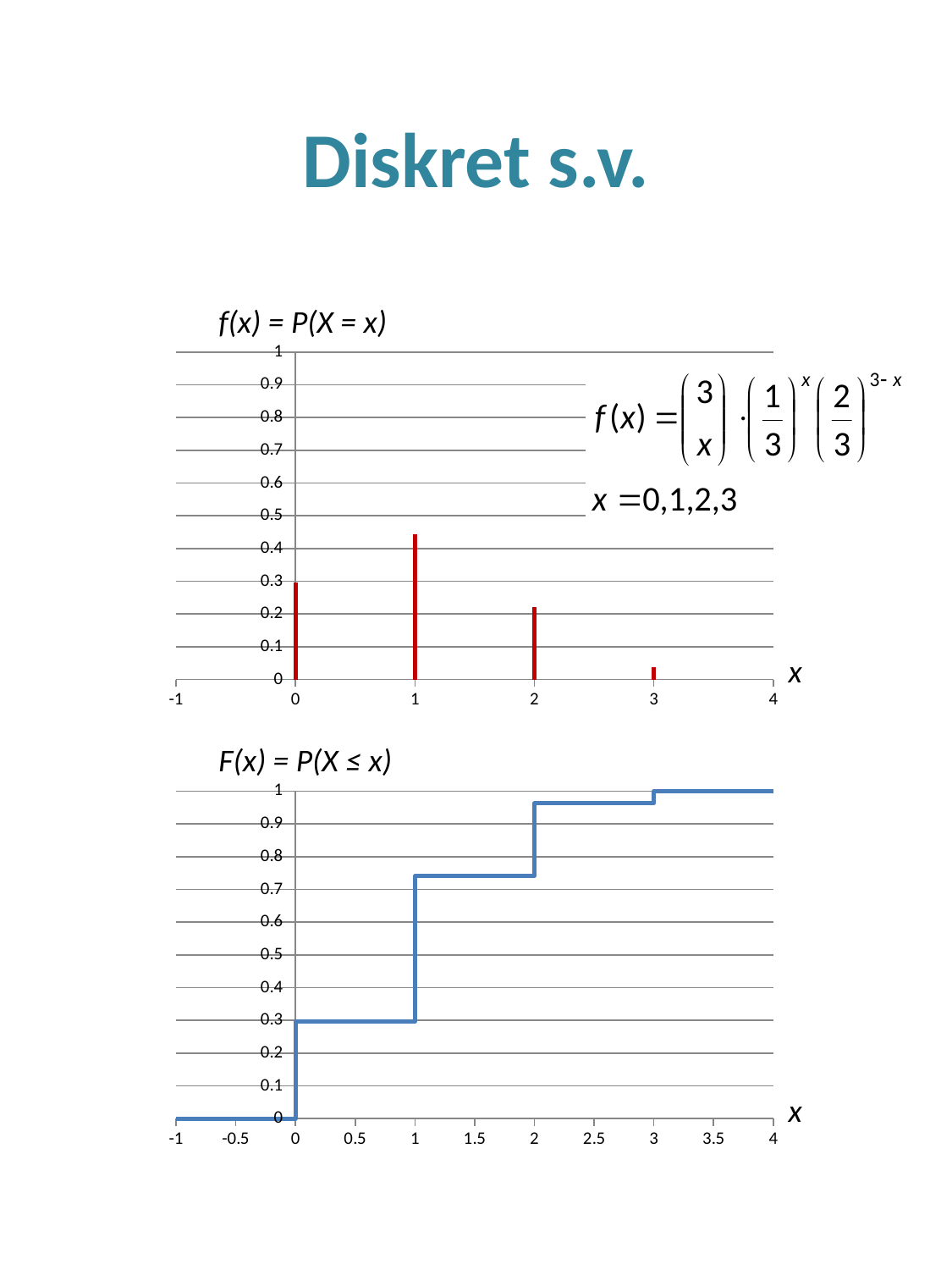
In the top chart f(x) = P(X = x), is the value at x = 1 greater or less than 0.4? greater In the bottom chart F(x) = P(X ≤ x), is the value at x = 0.5 greater or less than 0.4? less In the top chart f(x) = P(X = x), is the value at x = 3 greater or less than 0.1? less What colour is the line in the bottom chart F(x) = P(X ≤ x)? blue In the top chart f(x) = P(X = x), how many bars are plotted? 4 What kind of chart is the top chart titled f(x) = P(X = x)? bar chart In the top chart f(x) = P(X = x), which bar is taller, the one at x = 0 or the one at x = 2? x = 0 In the bottom chart F(x) = P(X ≤ x), what is the value of F(x) at x = 4? 1 In the top chart f(x) = P(X = x), at which value of x is the bar lowest? 3 In the top chart f(x) = P(X = x), at which value of x is the bar highest? 1 In the bottom chart F(x) = P(X ≤ x), do the values rise or fall as x increases? rise